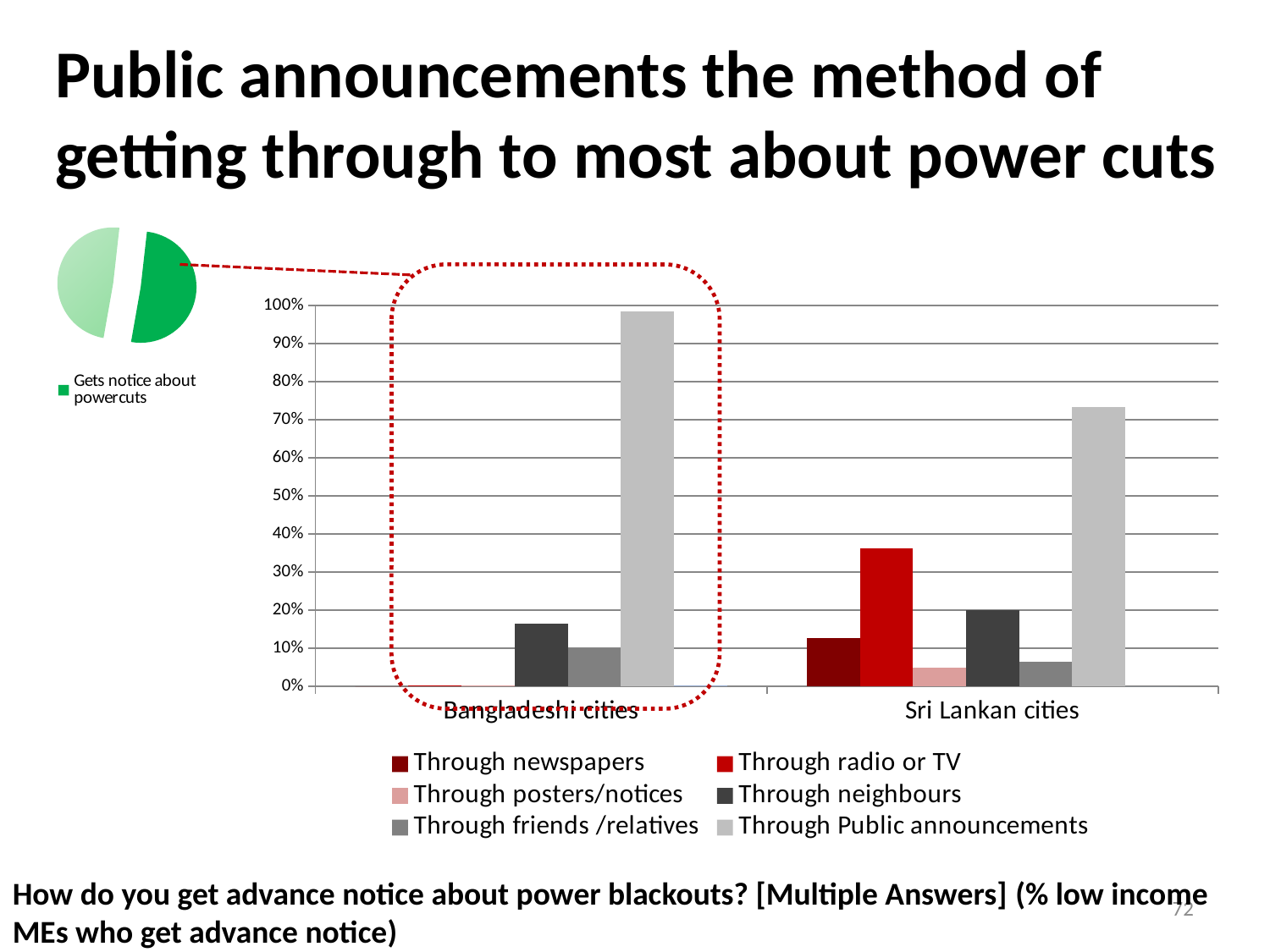
In the bar chart, which is larger for Sri Lankan cities: Through radio or TV or Through neighbours? Through radio or TV In the bar chart, is the value for Through Public announcements in Sri Lankan cities greater or less than 70%? greater What is the title of the slide? Public announcements the method of getting through to most about power cuts What kind of chart is the main chart on the slide? bar chart In the bar chart, which series has the highest value for Sri Lankan cities? Through Public announcements How many categories are shown on the x axis of the bar chart? 2 In the bar chart, which category has the larger value for Through Public announcements: Bangladeshi cities or Sri Lankan cities? Bangladeshi cities In the bar chart, is the value for Through Public announcements in Bangladeshi cities greater or less than 90%? greater In the bar chart, which series has the highest value for Bangladeshi cities? Through Public announcements In the bar chart, is the value for Through radio or TV in Sri Lankan cities greater or less than 30%? greater How many series does the legend of the bar chart list? 6